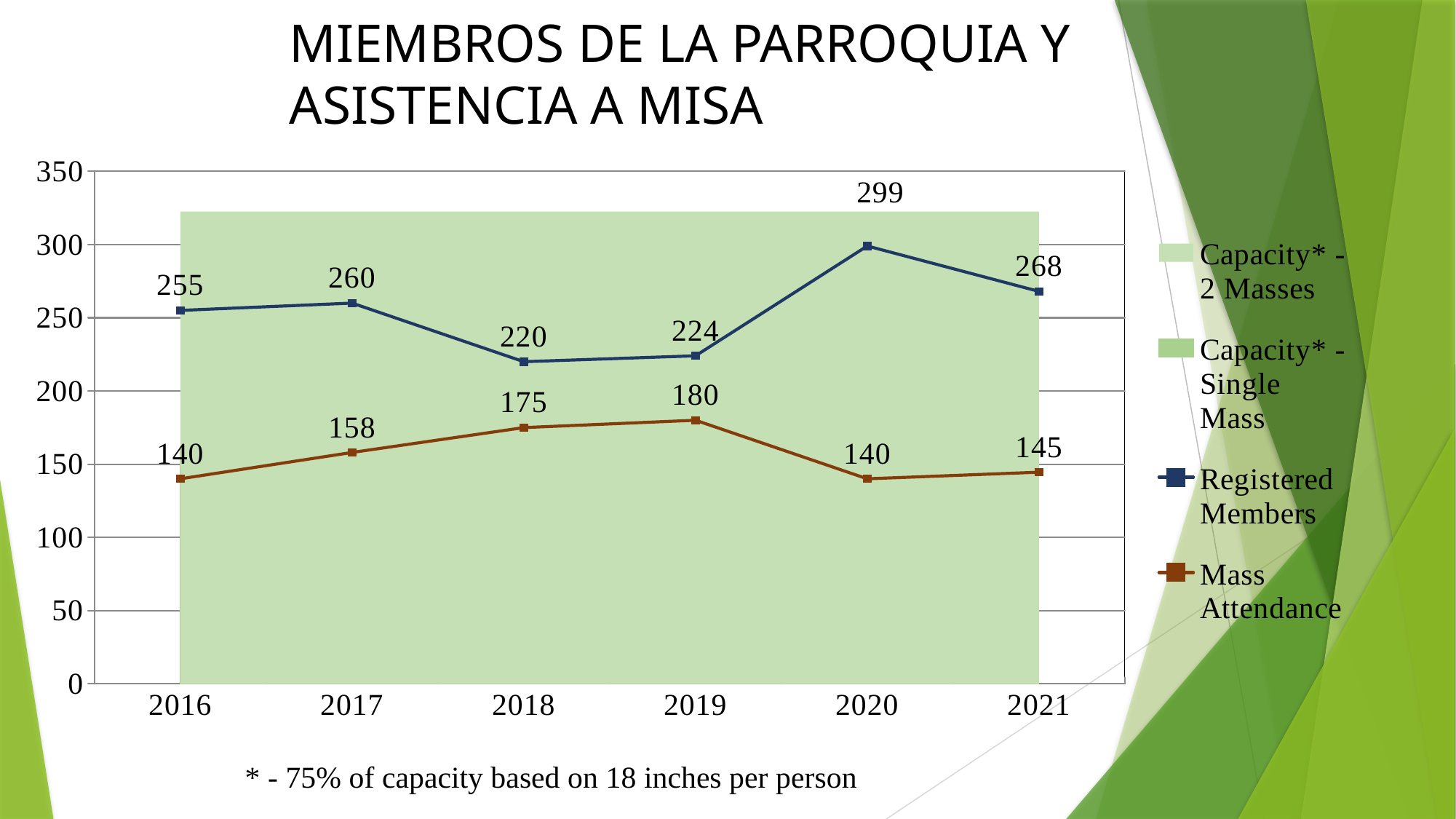
In which year is Mass Attendance highest? 2019 What is the Mass Attendance value in 2019? 180 Does Mass Attendance rise or fall from 2016 to 2019? rise In which year is Registered Members lowest? 2018 How many years are shown on the x axis? 6 How many entries does the legend list? 4 By how much did Registered Members fall from 2020 to 2021? 31 Which year has the larger Mass Attendance, 2017 or 2021? 2017 What kind of chart is this? combination area and line chart What is the difference between Registered Members and Mass Attendance in 2016? 115 What is the value for Registered Members in 2020? 299 In which year is Registered Members highest? 2020